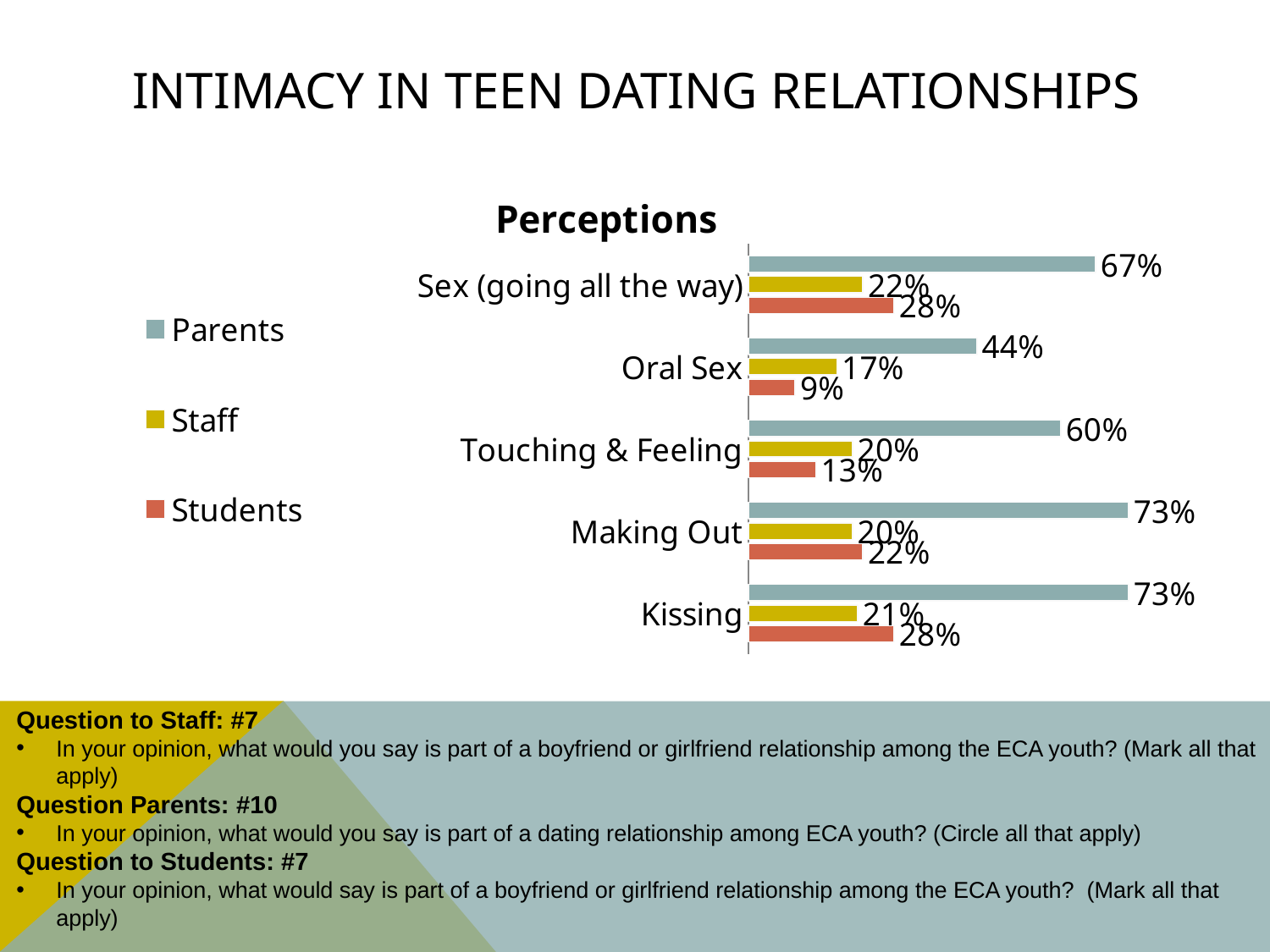
Which category has the lowest Parents value? Oral Sex Which category has the lowest Students value? Oral Sex What is the Parents value for Oral Sex? 44% How many categories are shown on the chart? 5 For Oral Sex, which is larger: the Staff value or the Students value? Staff Which category has the highest Staff value? Sex (going all the way) What is the title of the chart? Perceptions What is the Staff value for Kissing? 21% What type of chart is shown on the slide? bar chart What is the Students value for Touching & Feeling? 13% How many series does the legend list? 3 What is the difference between the Parents and Students values for Sex (going all the way)? 39%